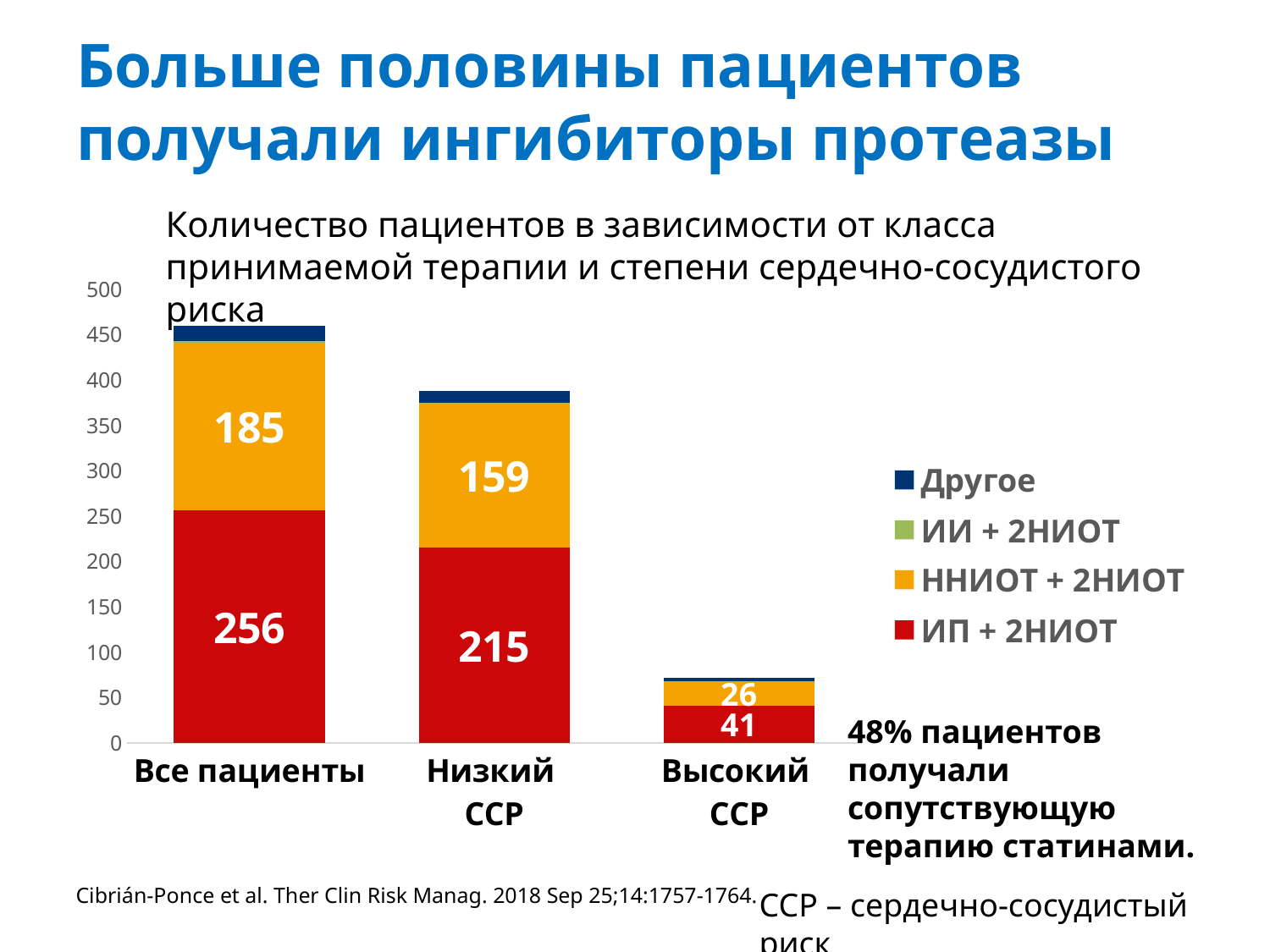
What is the value of ННИОТ + 2НИОТ for Низкий ССР? 159 Which series is shown in red in the chart? ИП + 2НИОТ Is the total height of the stacked bar for Все пациенты greater or less than 400? greater What is the difference between the ИП + 2НИОТ values for Низкий ССР and Высокий ССР? 174 What is the value of ИП + 2НИОТ for Все пациенты? 256 What is the value of ННИОТ + 2НИОТ for Высокий ССР? 26 How many series does the chart legend list? 4 What is the value of ИП + 2НИОТ for Высокий ССР? 41 Which is larger for Низкий ССР: ИП + 2НИОТ or ННИОТ + 2НИОТ? ИП + 2НИОТ How many categories are shown on the x axis of the chart? 3 Which category has the lowest value for ИП + 2НИОТ? Высокий ССР What kind of chart is shown on the slide? bar chart